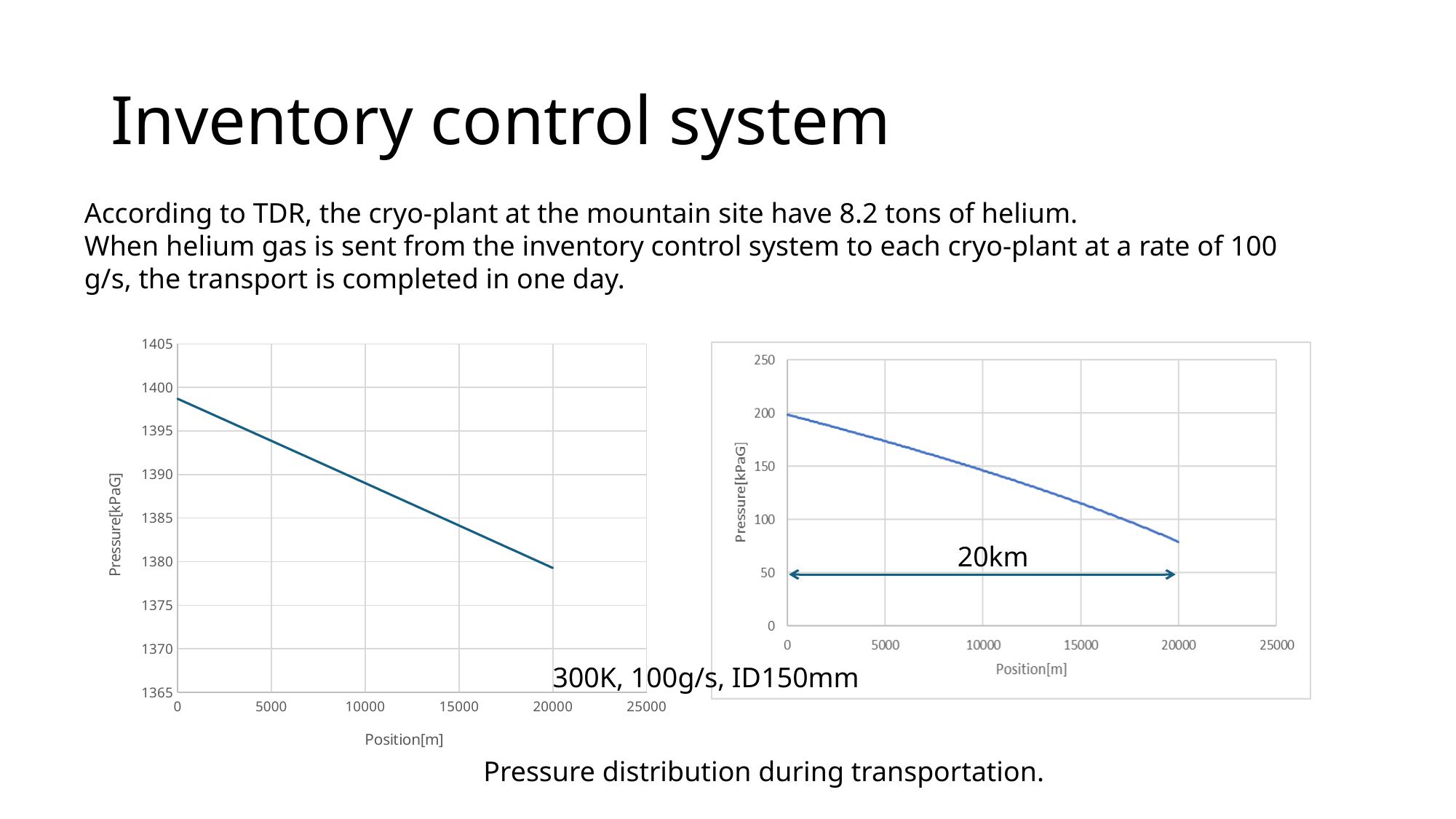
What is the y-axis label of the left chart? Pressure[kPaG] In the left chart, which position has the lower pressure, 5000 or 15000? 15000 In the right chart, is the pressure at position 0 greater or less than 150? greater In the right chart, is the pressure at position 20000 greater or less than 100? less What kind of chart is the right chart on the slide? line chart In the left chart, does the pressure rise or fall as position increases? fall What is the x-axis label of the right chart? Position[m] In the left chart, is the pressure at position 20000 greater or less than 1385? less In the right chart, which position has the higher pressure, 0 or 20000? 0 In the right chart, does the pressure rise or fall as position increases? fall What kind of chart is the left chart on the slide? line chart